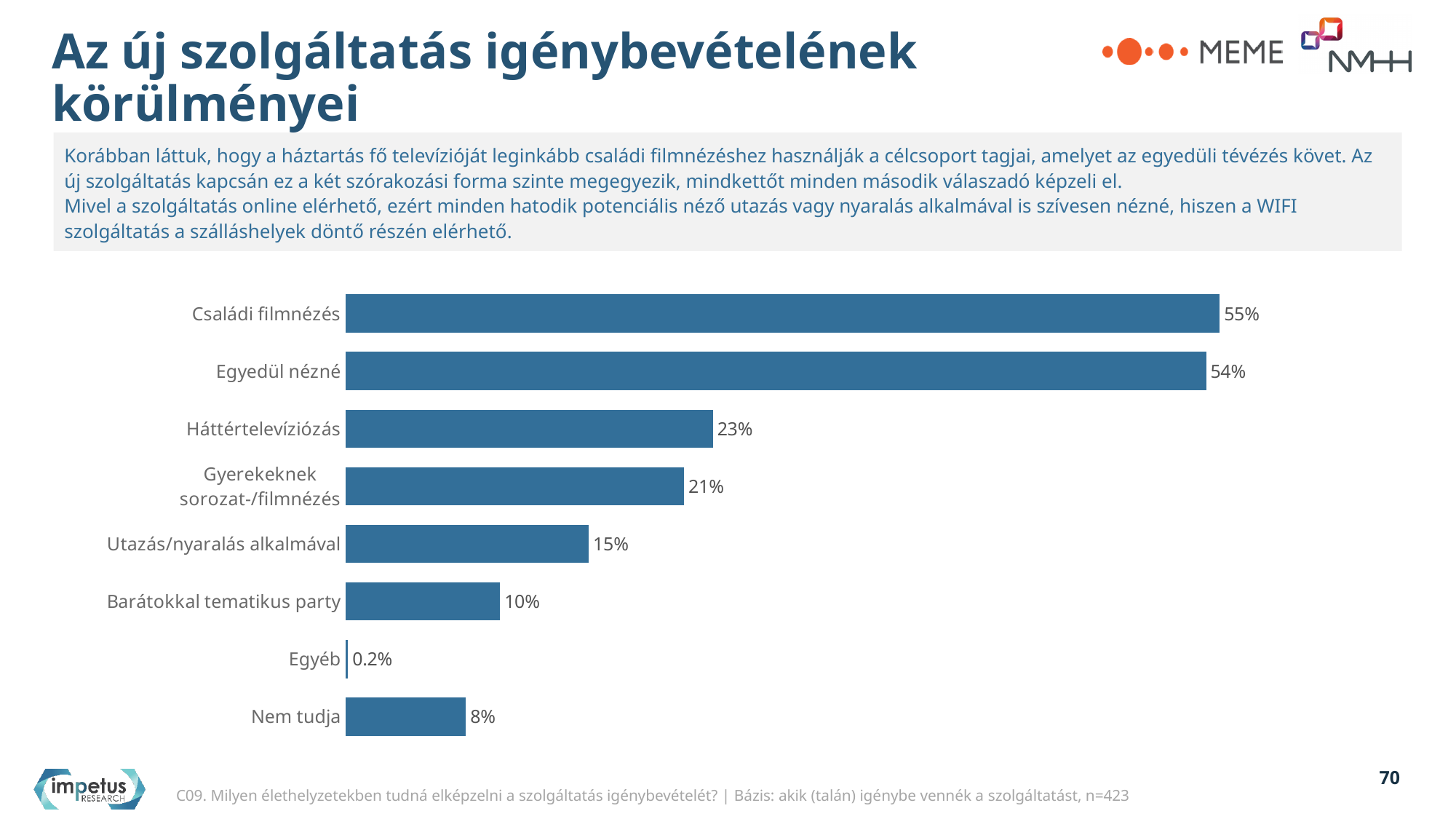
What is the difference between Háttértelevíziózás and Gyerekeknek sorozat-/filmnézés? 2% How many categories are shown in the chart? 8 What is the difference between Családi filmnézés and Barátokkal tematikus party? 45% Which category has the highest value? Családi filmnézés What is the value for Családi filmnézés? 55% Which is larger, Háttértelevíziózás or Utazás/nyaralás alkalmával? Háttértelevíziózás What is the value for Utazás/nyaralás alkalmával? 15% What kind of chart is shown on the slide? Bar chart What is the sample size (n) stated in the footnote below the chart? n=423 What is the value for Egyéb? 0.2% Which category has the lowest value? Egyéb What is the value for Nem tudja? 8%